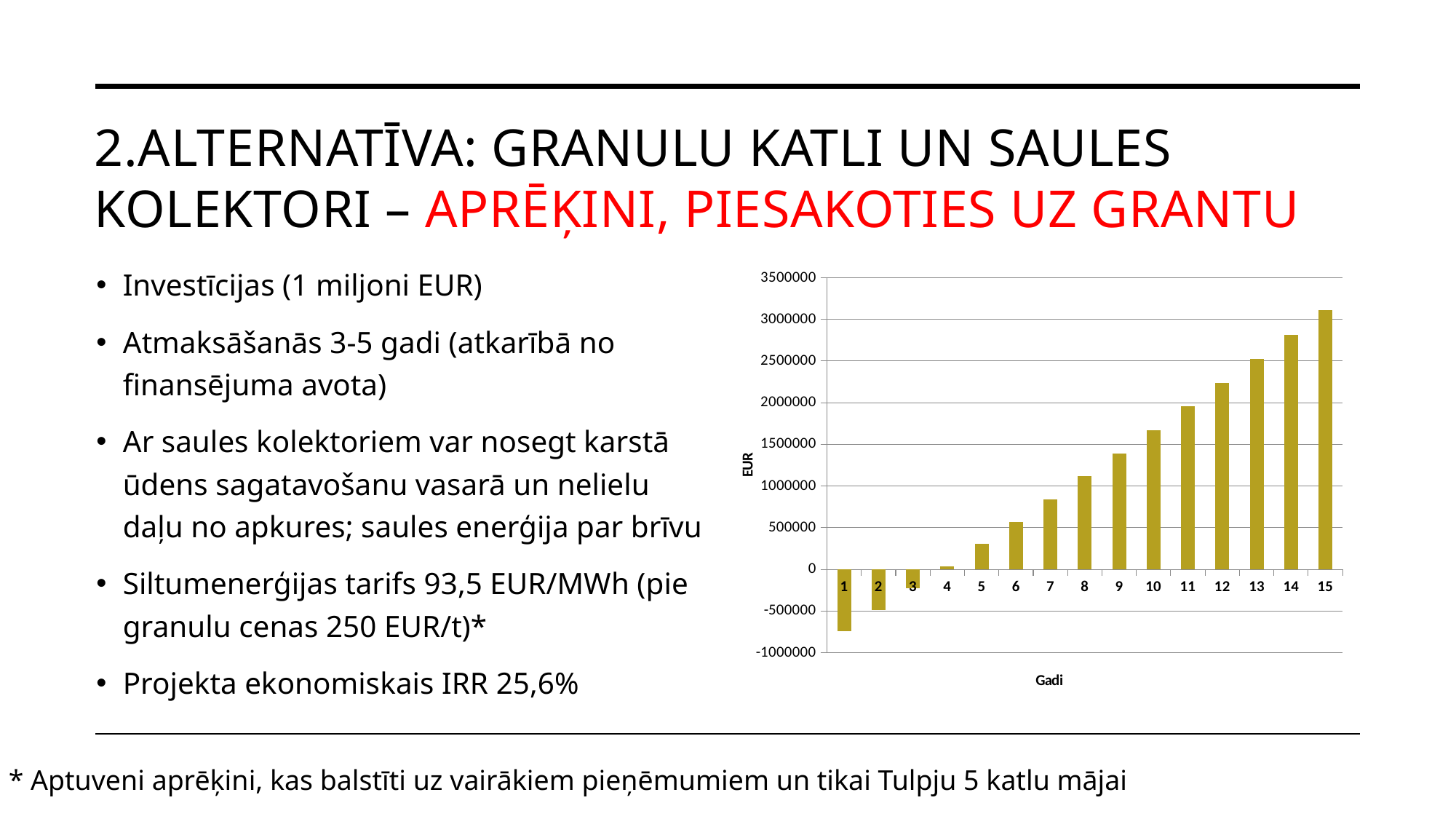
Is the value for year 9 greater or less than 1000000? greater Which year has the lowest value on the chart? 1 Do the values generally rise or fall from year 1 to year 15? rise What is the label of the horizontal axis of the chart? Gadi Is the value for year 5 greater or less than 500000? less Which year has the highest value on the chart? 15 Is the value for year 12 greater or less than 2000000? greater Which has the larger value, year 6 or year 10? year 10 How many years (bars) are plotted on the chart? 15 What kind of chart is shown on the slide? bar chart